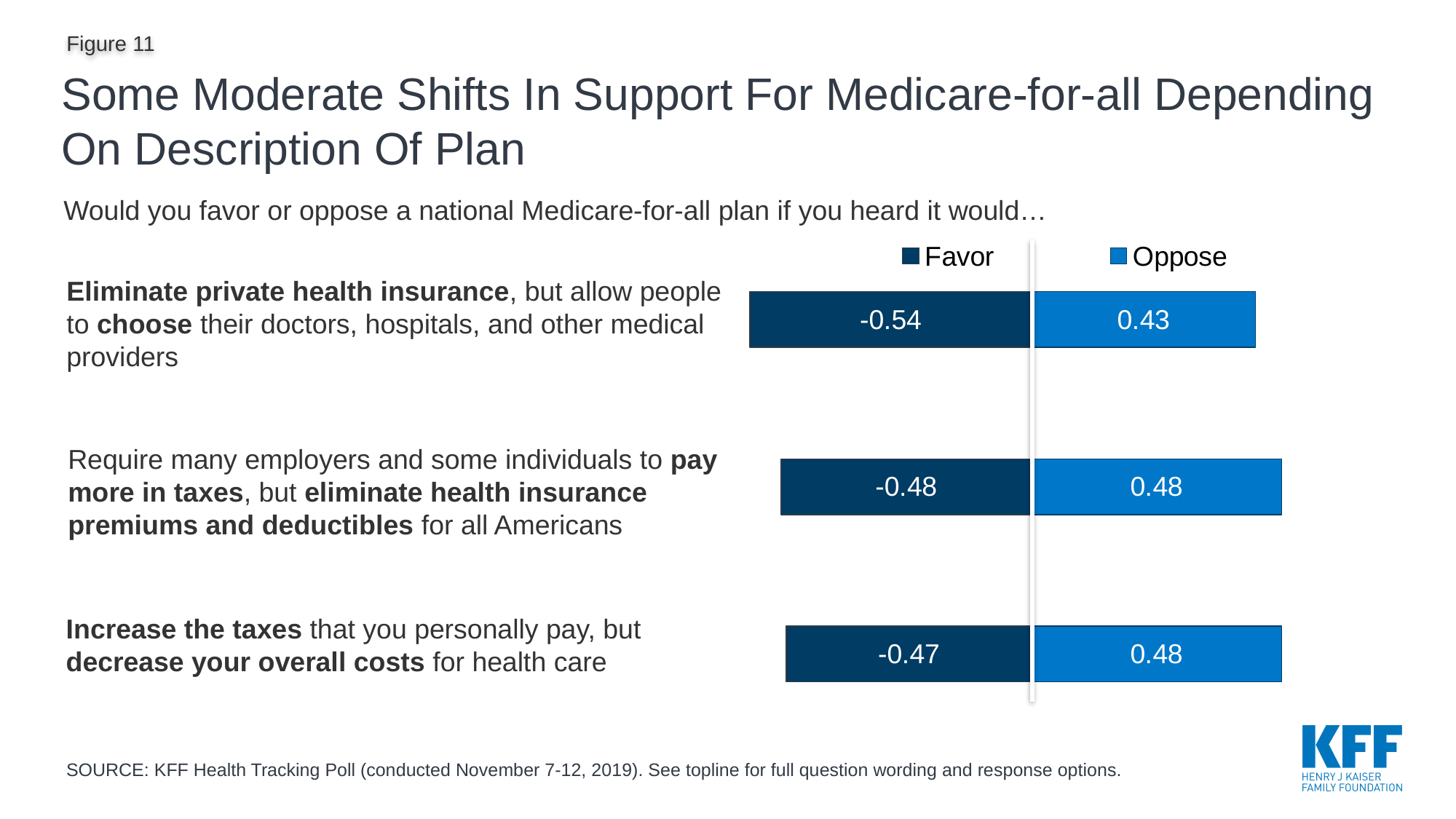
What kind of chart is shown on the slide? Bar chart What is the Oppose value for the plan that would eliminate private health insurance but allow people to choose their doctors? 0.43 Which plan description has the longest Favor bar? Eliminate private health insurance, but allow people to choose their doctors, hospitals, and other medical providers Which plan description has the lowest Oppose value? Eliminate private health insurance, but allow people to choose their doctors, hospitals, and other medical providers How many series does the legend list? 2 What is the Favor value for the plan that would increase the taxes you personally pay but decrease your overall health care costs? -0.47 How many plan descriptions are shown in the chart? 3 What is the difference between the Oppose value for the pay-more-in-taxes plan and the Oppose value for the eliminate-private-insurance plan? 0.05 What is the Oppose value for the plan that would increase the taxes you personally pay but decrease your overall health care costs? 0.48 What is the Favor value for the plan that would eliminate private health insurance but allow people to choose their doctors? -0.54 Is the Oppose value larger for the eliminate-private-insurance plan or for the increase-your-personal-taxes plan? Increase the taxes that you personally pay, but decrease your overall costs for health care What is the Favor value for the plan that would require many employers and some individuals to pay more in taxes but eliminate premiums and deductibles? -0.48